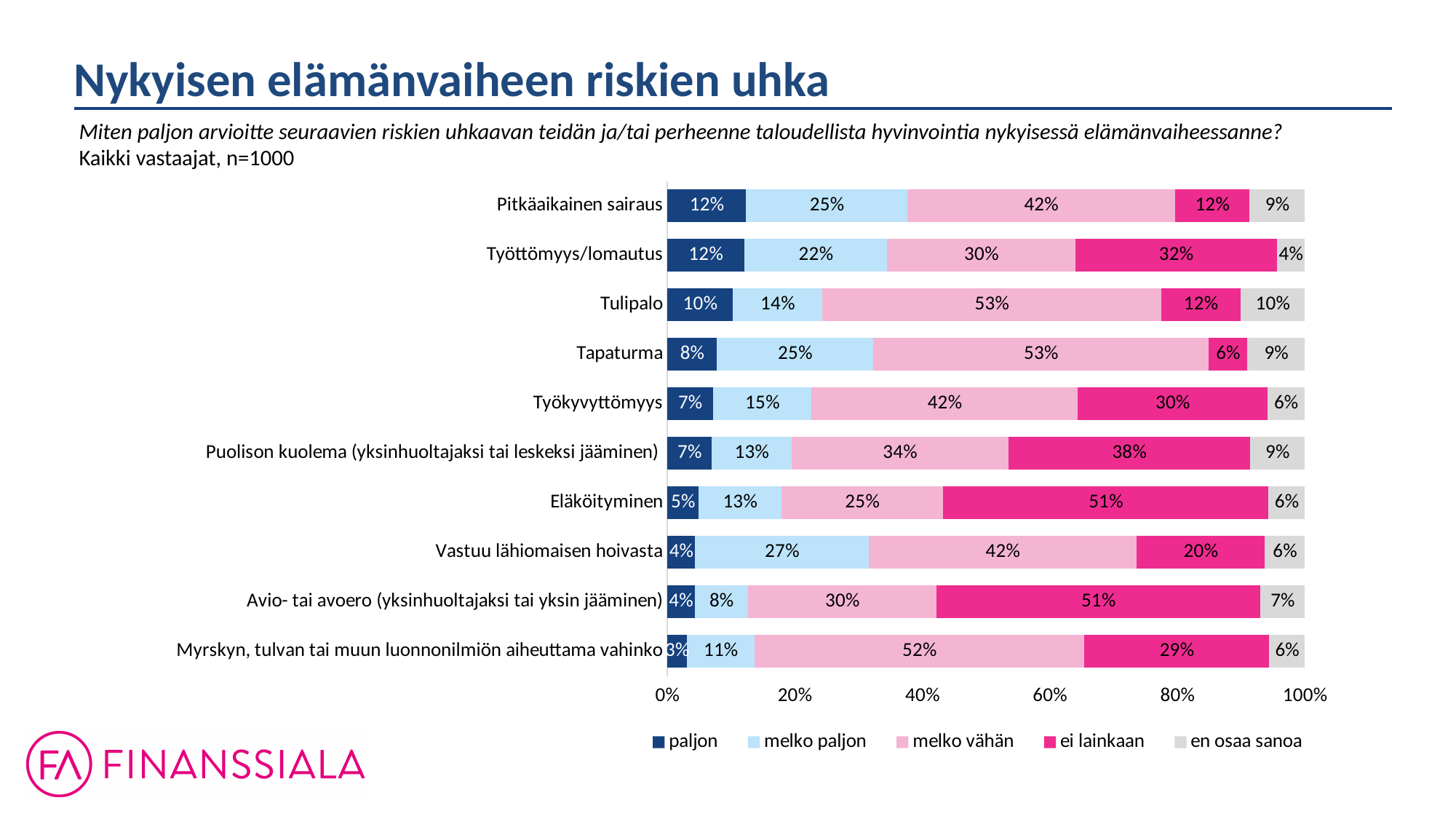
What is the difference in percentage points between the "ei lainkaan" value for Eläköityminen and for Pitkäaikainen sairaus? 39 percentage points What percentage of respondents answered "paljon" for Pitkäaikainen sairaus? 12% Which category has the lowest "paljon" value? Myrskyn, tulvan tai muun luonnonilmiön aiheuttama vahinko How many series does the legend list? 5 What is the "ei lainkaan" value for Eläköityminen? 51% Which is larger: the "ei lainkaan" value for Työttömyys/lomautus or for Tulipalo? Työttömyys/lomautus Which category has the highest "melko paljon" value? Vastuu lähiomaisen hoivasta How many risk categories are shown in the chart? 10 What kind of chart is shown on the slide? Stacked bar chart What is the total of the stacked bar for Pitkäaikainen sairaus? 100% What is the "melko vähän" value for Myrskyn, tulvan tai muun luonnonilmiön aiheuttama vahinko? 52% Which category has the lowest "ei lainkaan" value? Tapaturma